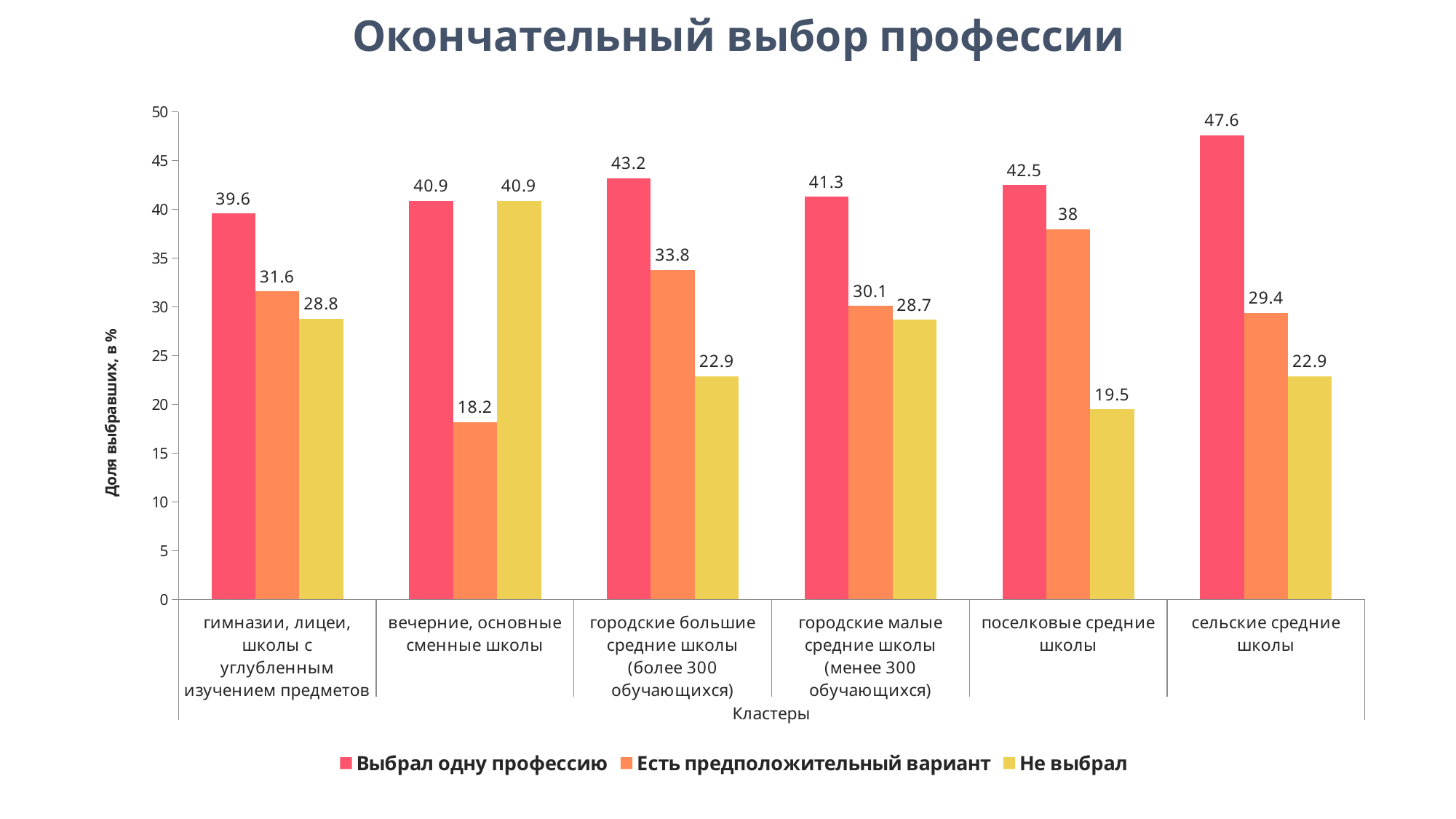
Which is larger in the 'городские малые средние школы (менее 300 обучающихся)' cluster: 'Есть предположительный вариант' or 'Не выбрал'? Есть предположительный вариант What is the value for 'Есть предположительный вариант' in the 'поселковые средние школы' cluster? 38 Is the value for 'Не выбрал' in the 'поселковые средние школы' cluster greater or less than 20? less What is the value for 'Выбрал одну профессию' in the 'сельские средние школы' cluster? 47.6 What is the title of the chart? Окончательный выбор профессии How many clusters are shown on the x axis? 6 What is the value for 'Не выбрал' in the 'вечерние, основные сменные школы' cluster? 40.9 Which cluster has the lowest value for 'Есть предположительный вариант'? вечерние, основные сменные школы Which cluster has the highest value for 'Выбрал одну профессию'? сельские средние школы How many series does the legend list? 3 What kind of chart is shown on the slide? bar chart What is the difference between 'Выбрал одну профессию' and 'Не выбрал' in the 'поселковые средние школы' cluster? 23